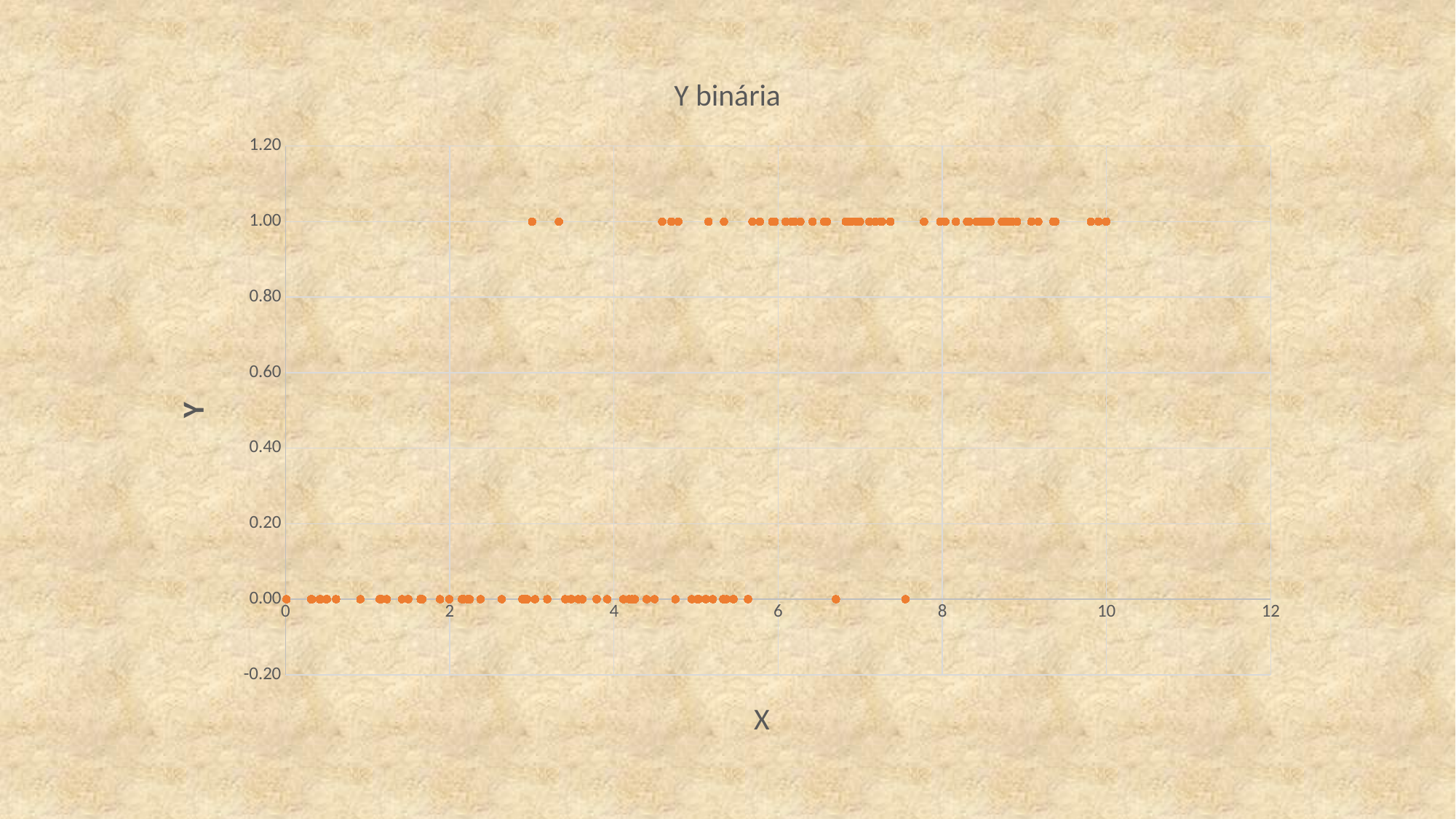
Do the Y values tend to rise or fall as X increases? rise What is the lowest tick value shown on the Y axis? -0.20 What is the label of the horizontal axis? X Is the Y value of the points near X = 1 greater or less than 0.20? less How many distinct Y levels do the plotted points fall on? 2 What is the title of the chart? Y binária What kind of chart is shown on the slide? scatter plot Is the Y value of the points near X = 9 greater or less than 0.80? greater What is the highest Y value reached by any point in the chart? 1.00 What is the largest value shown on the X axis? 12 Which has the larger Y value: the point at about X = 9.9 or the point at about X = 0.5? the point at about X = 9.9 What is the lowest Y value reached by any point in the chart? 0.00